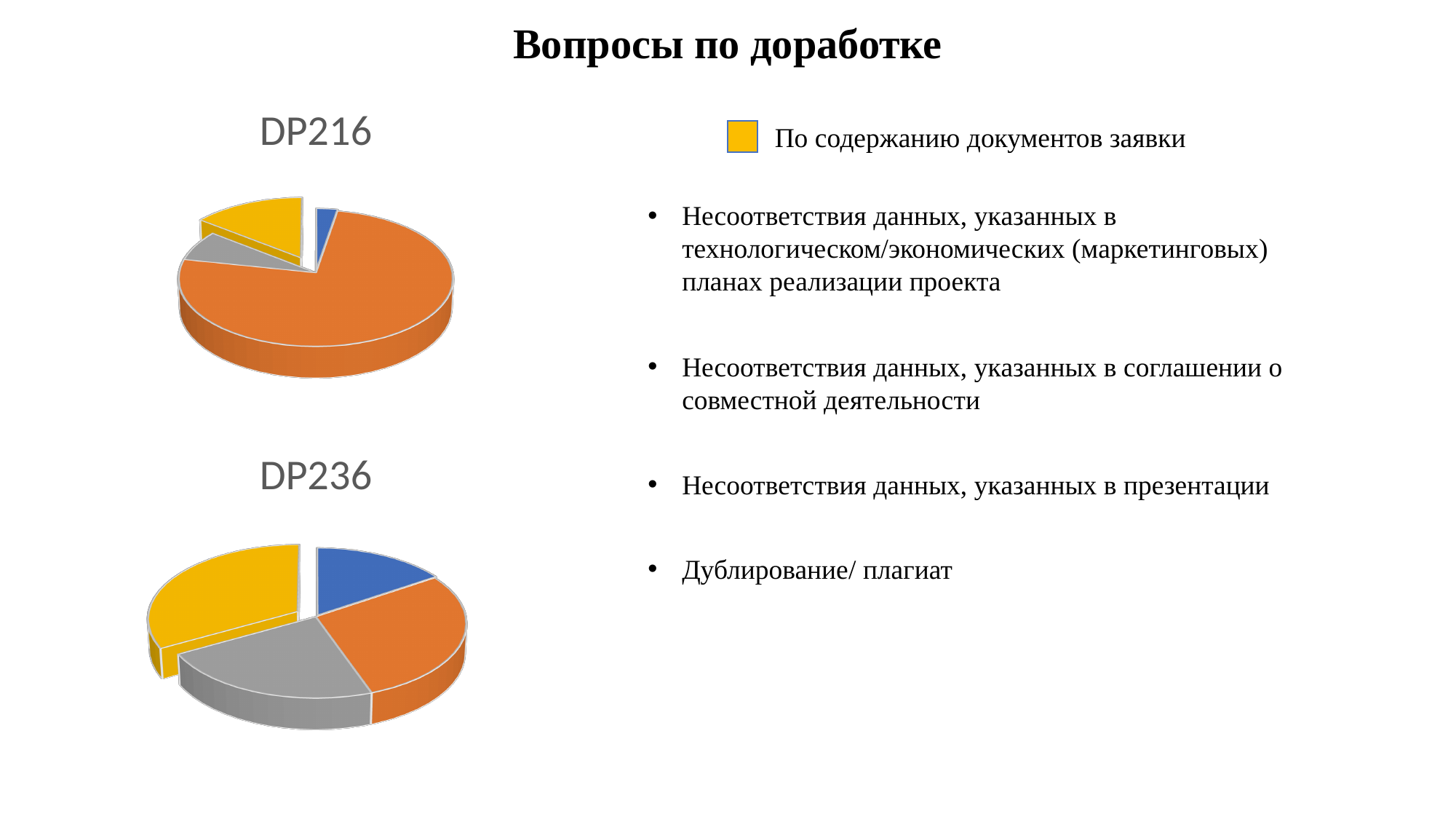
How many slices does the DP236 pie chart have? 4 In the DP236 pie chart, which is larger, the orange slice or the blue slice? orange What is the title of the upper pie chart on the slide? DP216 How many slices does the DP216 pie chart have? 4 According to the legend on the slide, what category does the yellow slice represent? По содержанию документов заявки In the DP216 pie chart, which colour slice is the largest? orange In the DP236 pie chart, which colour slice is the smallest? blue What kind of chart is the DP236 chart? pie chart In the DP216 pie chart, which is larger, the yellow slice or the gray slice? yellow In the DP236 pie chart, which is larger, the gray slice or the blue slice? gray In the DP216 pie chart, which colour slice is the smallest? blue What kind of chart is the DP216 chart? pie chart